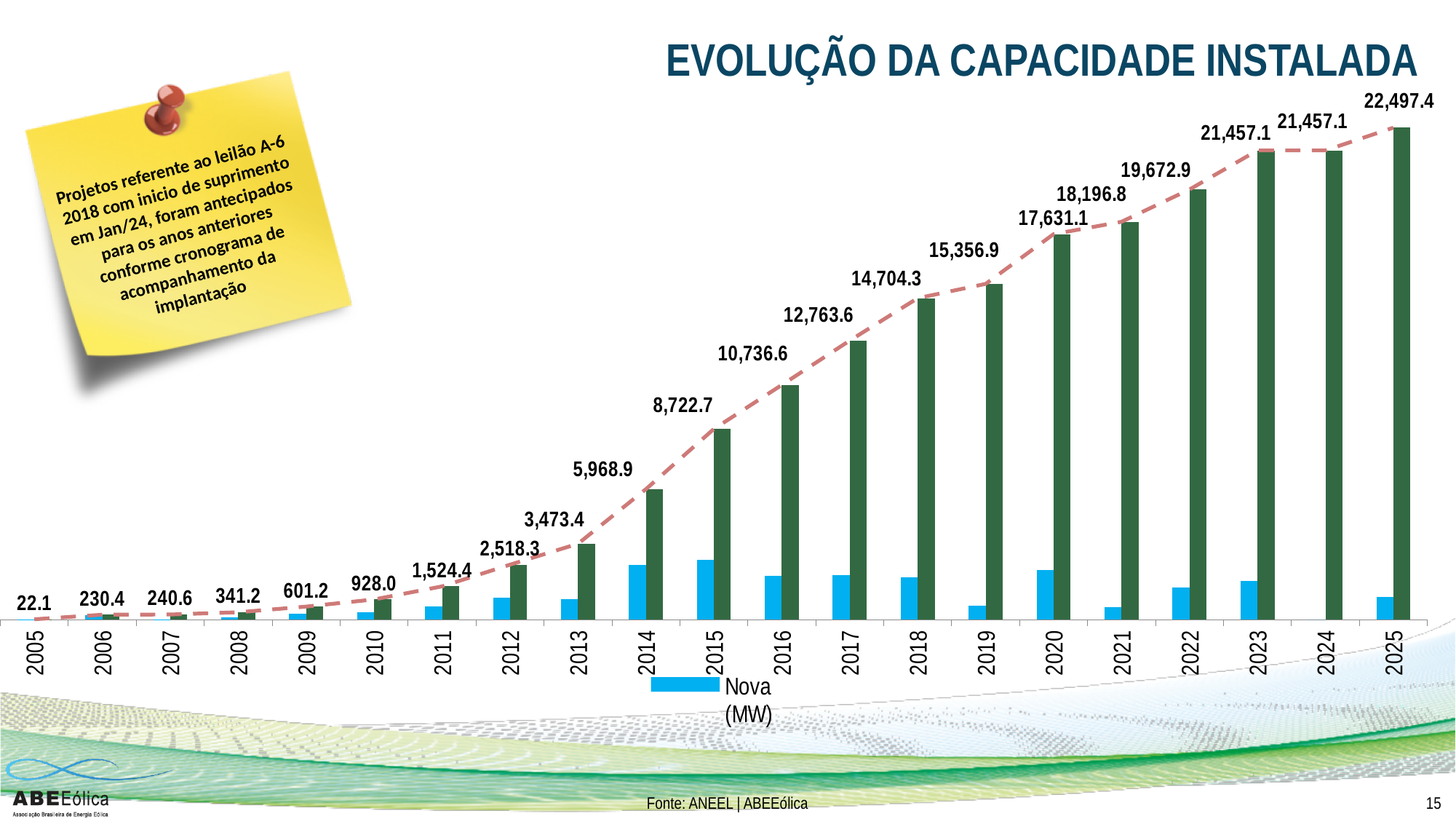
What is the difference between the labelled values for 2025 and 2024? 1,040.3 What is the labelled value for 2015? 8,722.7 What is the labelled value for 2010? 928.0 How many years are shown on the x axis? 21 Which is larger, the labelled value for 2018 or for 2019? 2019 Which year has the lowest labelled value? 2005 What is the title of the chart? EVOLUÇÃO DA CAPACIDADE INSTALADA What is the difference between the labelled values for 2014 and 2013? 2,495.5 Do the labelled values rise or fall from 2005 to 2025? Rise What is the labelled value for 2020? 17,631.1 What kind of chart is this? Bar chart with a dashed line Which year has the highest labelled value? 2025